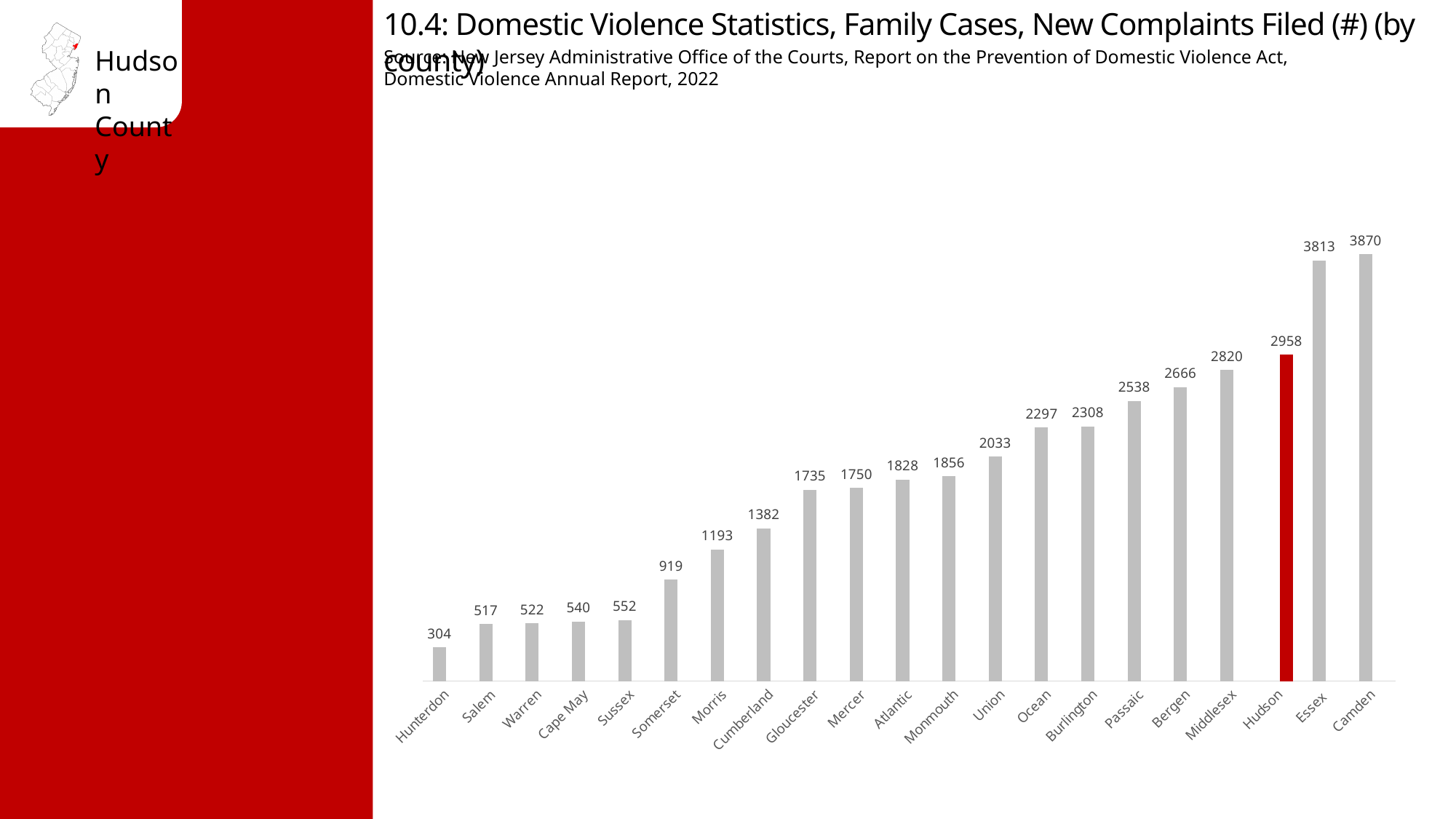
How many counties are shown on the chart? 21 What is the difference between the values for Essex and Hudson? 855 What is the number of new domestic violence complaints filed in Hudson County? 2958 What is the difference between the values for Camden and Hudson? 912 Which county's bar is highlighted in red? Hudson Do the values rise or fall from left to right along the x axis? Rise Which has a larger value, Bergen or Middlesex? Middlesex What kind of chart is shown on the slide? Bar chart What is the value shown for Camden? 3870 What is the value shown for Hunterdon? 304 Which county has the highest number of new complaints filed? Camden Which county has the lowest number of new complaints filed? Hunterdon